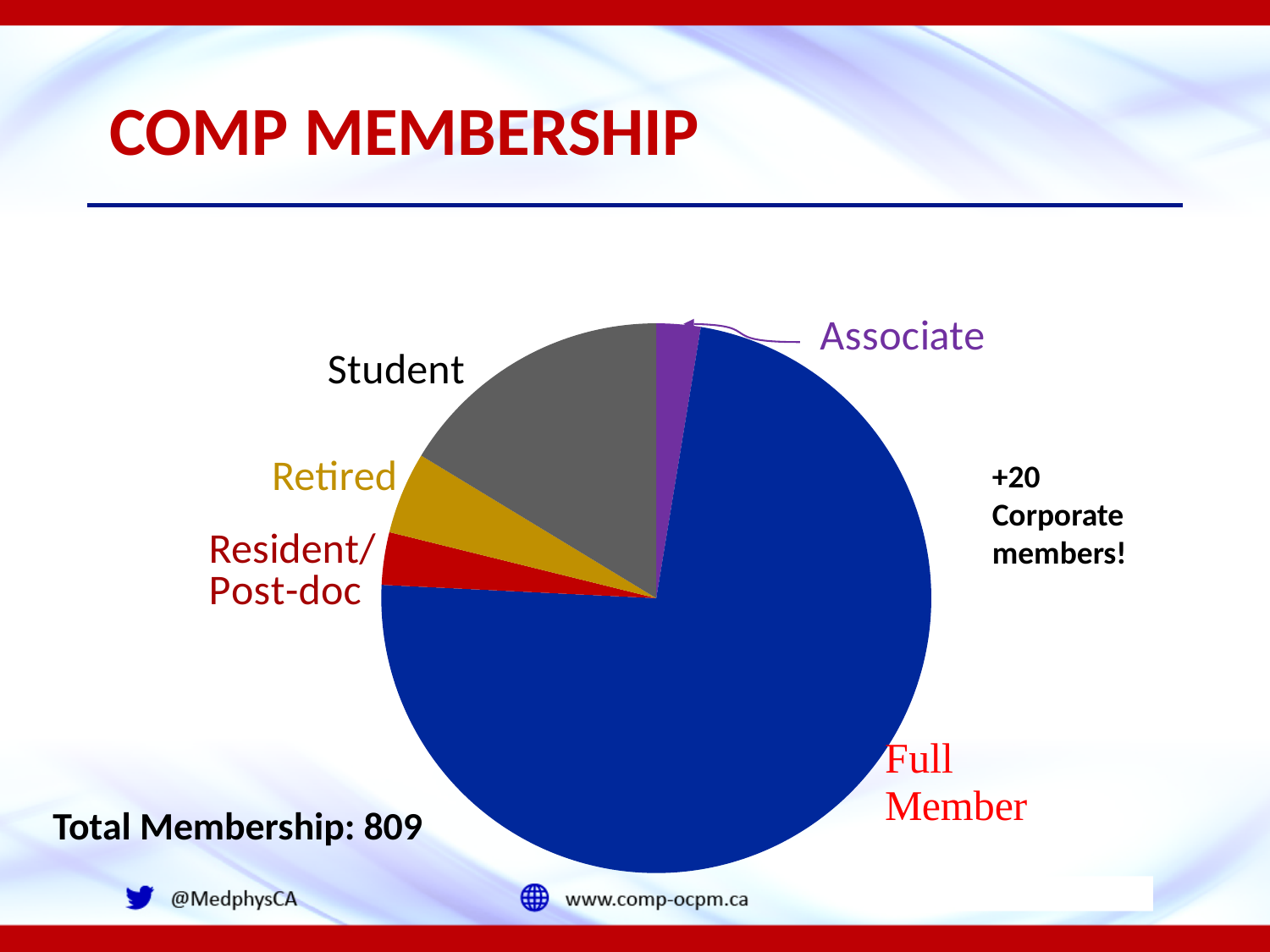
Which membership category has the smallest slice of the pie chart? Associate Which slice is larger, Full Member or Student? Full Member Which membership category has the largest slice of the pie chart? Full Member Which slice is larger, Student or Retired? Student How many slices does the pie chart have? 5 Which category has the second-largest slice of the pie chart? Student Which slice is larger, Student or Associate? Student What kind of chart is shown on the slide? pie chart What colour is the Full Member slice of the pie chart? blue What is the title of the slide containing the pie chart? COMP MEMBERSHIP